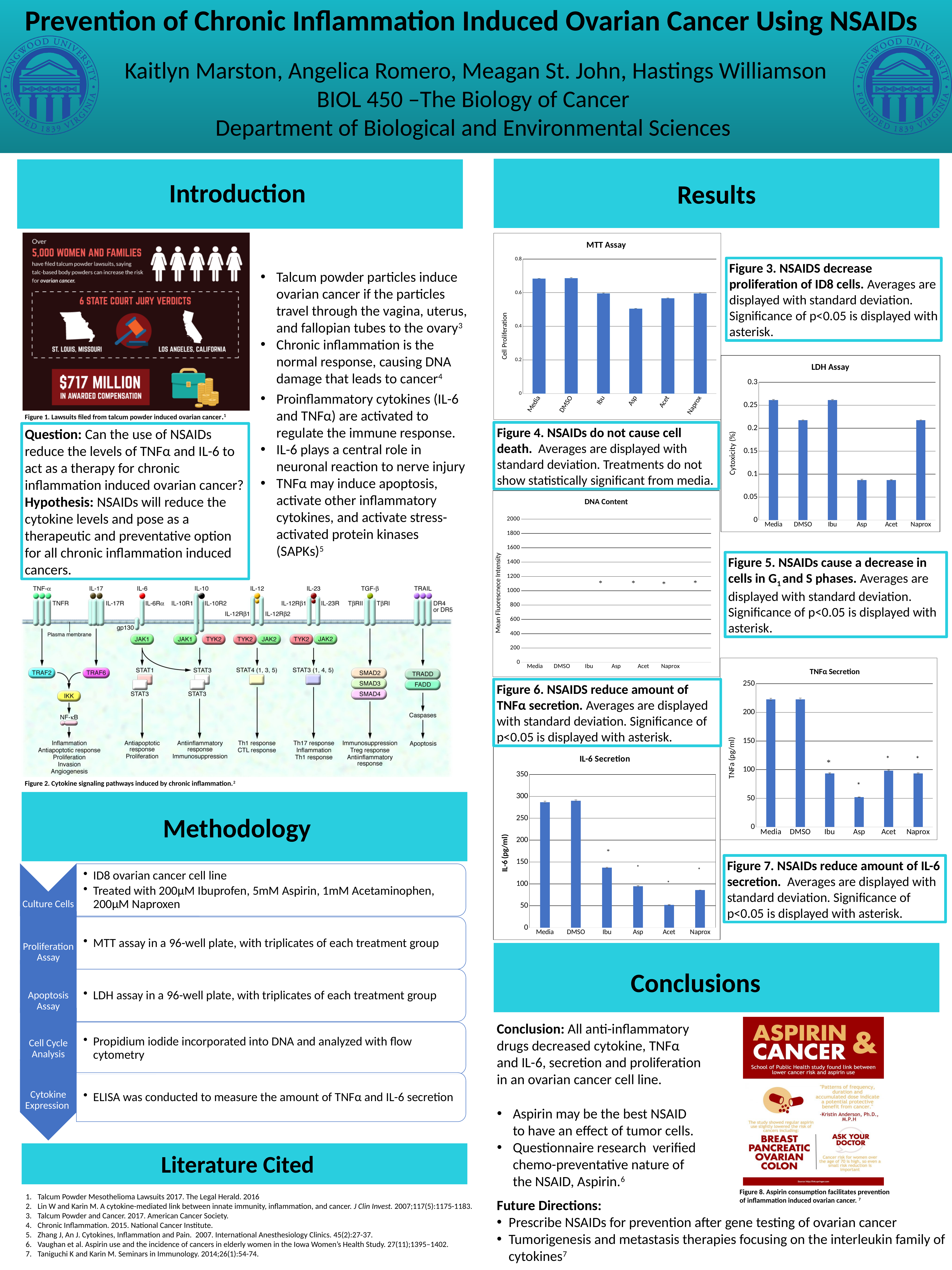
In the MTT Assay chart, is the value for Asp greater or less than 0.6? less In the IL-6 Secretion chart, is the value for Ibu greater or less than 100? greater In the LDH Assay chart, is the value for Asp greater or less than 0.1? less In the TNFα Secretion chart, which treatment has the lowest TNFα level? Asp How many treatment categories are shown on the x axis of the IL-6 Secretion chart? 6 In the MTT Assay chart, which treatment has the lowest cell proliferation? Asp What kind of chart is the TNFα Secretion chart? bar chart In the LDH Assay chart, which is larger, the value for DMSO or the value for Acet? DMSO In the IL-6 Secretion chart, which treatment has the lowest IL-6 level? Acet